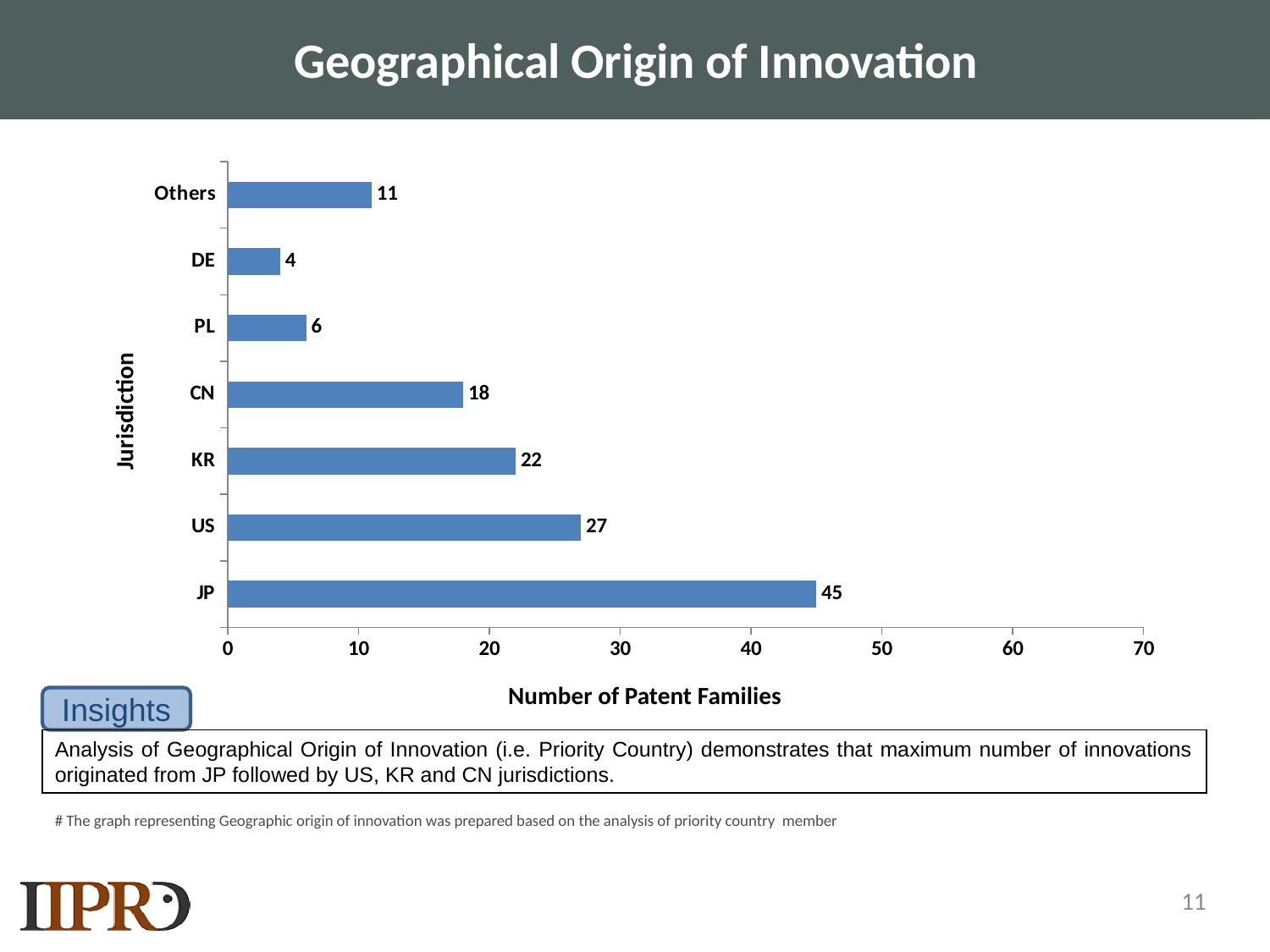
What is the label of the horizontal axis of the chart? Number of Patent Families What is the difference in number of patent families between JP and US? 18 Which jurisdiction has the lowest number of patent families? DE What is the number of patent families for JP? 45 Which jurisdiction has the highest number of patent families? JP How many jurisdictions are shown on the chart? 7 What is the number of patent families for DE? 4 What is the difference in number of patent families between CN and PL? 12 Is the value for US greater or less than 30? less What kind of chart is shown on the slide? Bar chart Which has more patent families, KR or CN? KR What is the number of patent families for KR? 22